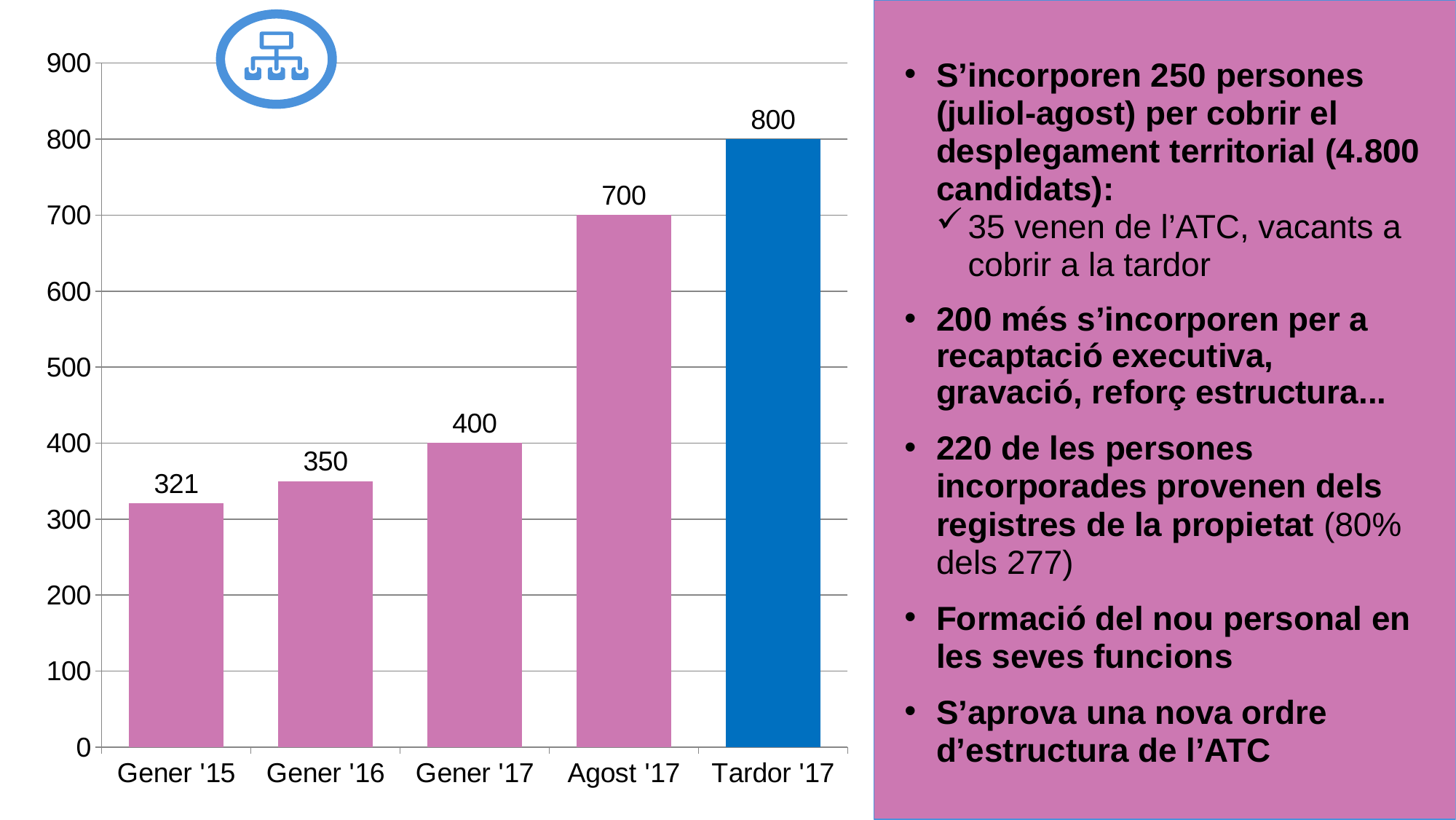
What is the difference between the values for Agost '17 and Gener '17? 300 What kind of chart is shown on the slide? bar chart Which category has the lowest value? Gener '15 What is the value for Gener '15? 321 What is the value for Gener '17? 400 Is the value for Gener '16 greater or less than 400? less Which category has the highest value? Tardor '17 How many categories are shown on the x axis? 5 Do the values rise or fall from Gener '15 to Tardor '17? rise What is the value for Agost '17? 700 Which is larger, the value for Gener '16 or the value for Gener '17? Gener '17 What is the difference between the values for Tardor '17 and Gener '15? 479